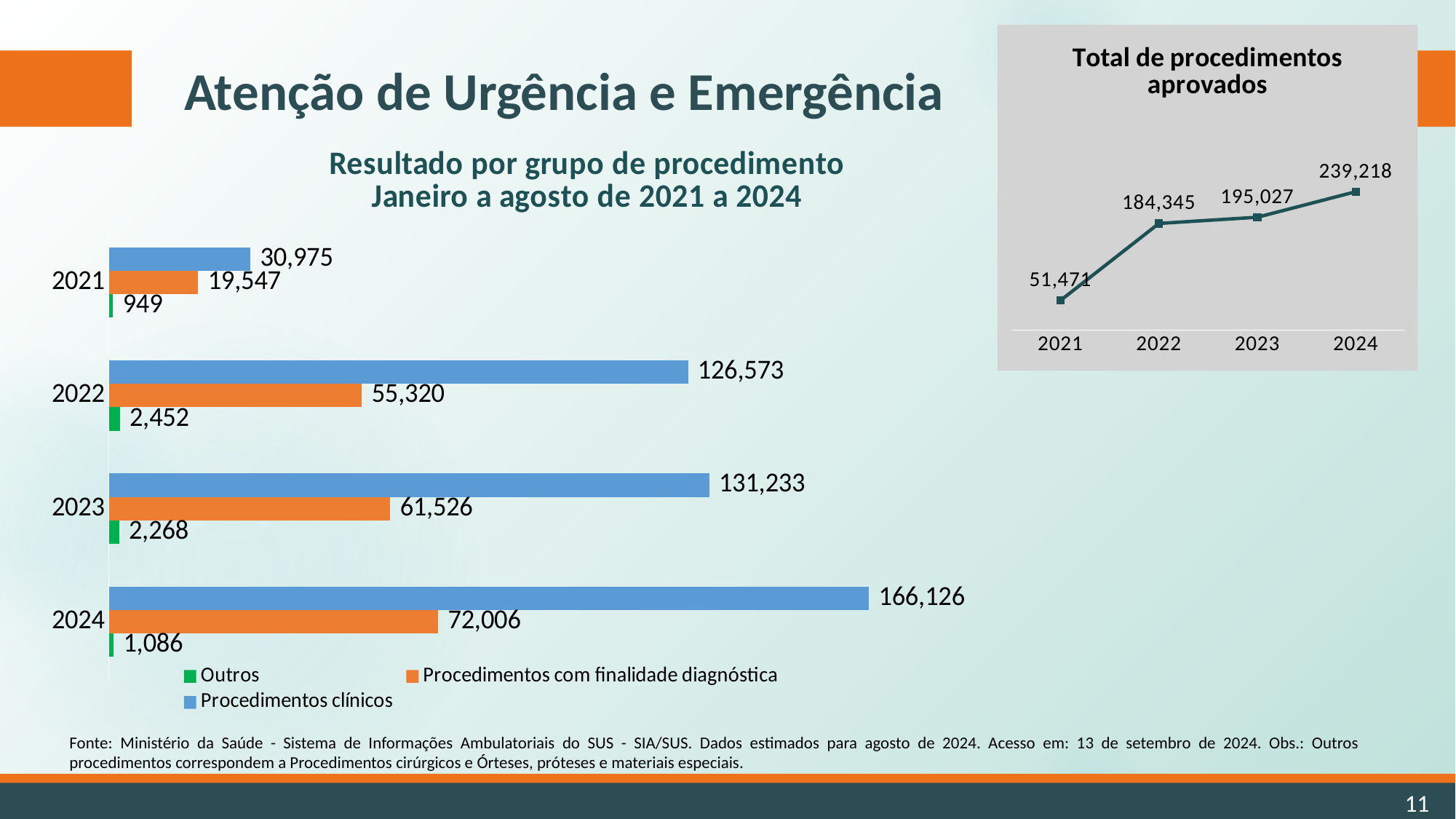
In the line chart 'Total de procedimentos aprovados', what is the difference between the 2024 and 2021 values? 187,747 In the bar chart 'Resultado por grupo de procedimento', which year has the lowest value for Procedimentos clínicos? 2021 In the bar chart 'Resultado por grupo de procedimento', what is the value of Outros for 2021? 949 What kind of chart is 'Resultado por grupo de procedimento'? Bar chart In the bar chart 'Resultado por grupo de procedimento', what is the value of Procedimentos com finalidade diagnóstica for 2022? 55,320 How many series does the legend of the bar chart 'Resultado por grupo de procedimento' list? 3 In the bar chart 'Resultado por grupo de procedimento', which year has the highest value for Outros? 2022 In the bar chart 'Resultado por grupo de procedimento', which is larger: Procedimentos com finalidade diagnóstica in 2023 or Outros in 2023? Procedimentos com finalidade diagnóstica in 2023 In the bar chart 'Resultado por grupo de procedimento', what is the difference between Procedimentos clínicos in 2023 and in 2022? 4,660 In the line chart 'Total de procedimentos aprovados', do the values rise or fall from 2021 to 2024? Rise In the line chart 'Total de procedimentos aprovados', what is the value for 2022? 184,345 In the bar chart 'Resultado por grupo de procedimento', what is the value of Procedimentos clínicos for 2024? 166,126